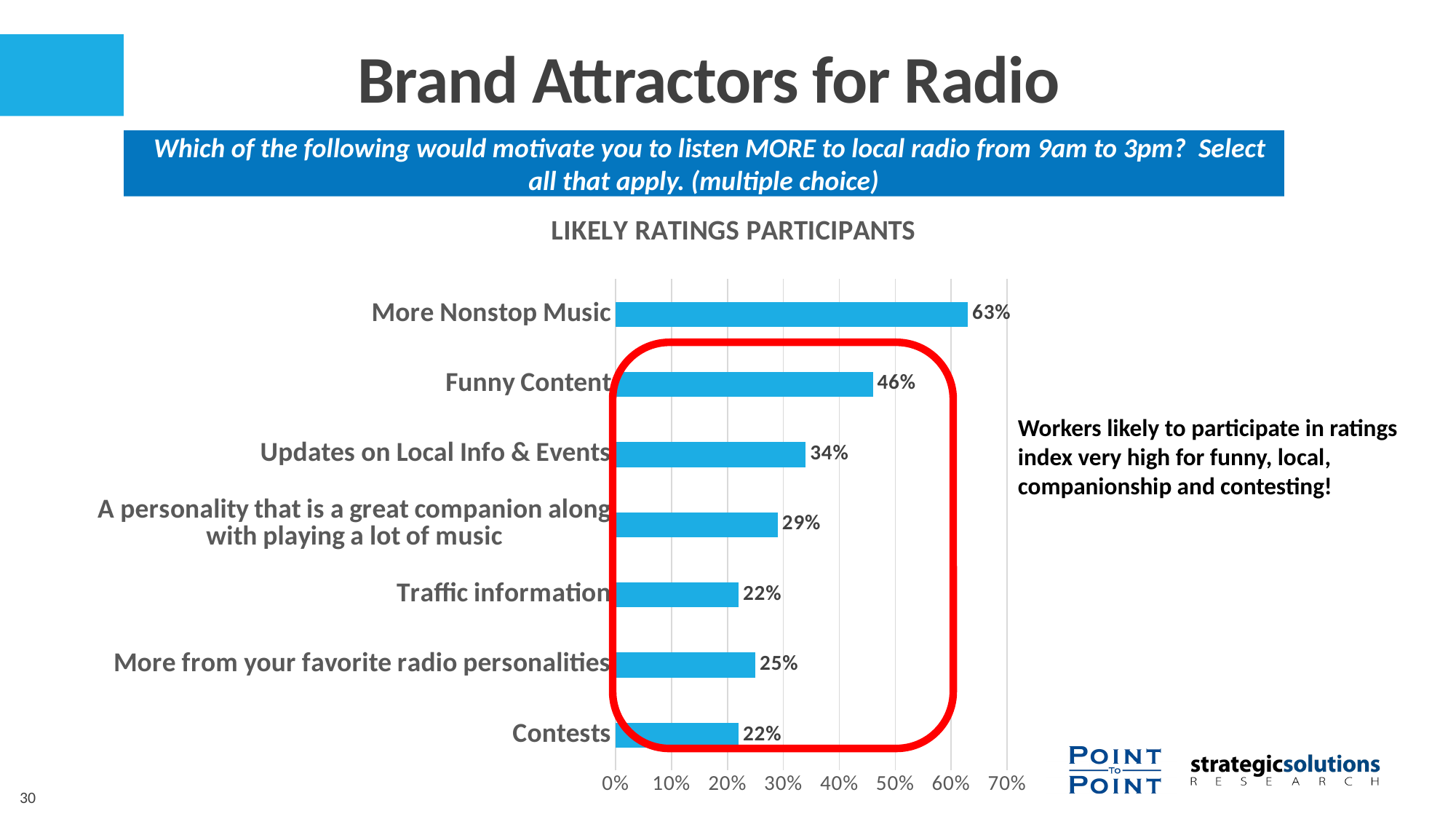
Is the value for A personality that is a great companion along with playing a lot of music greater or less than 20%? greater What is the value for Updates on Local Info & Events? 34% What is the value for Funny Content? 46% What percentage of likely ratings participants selected More Nonstop Music? 63% What is the difference between Updates on Local Info & Events and Traffic information? 12% Which is larger, the value for Traffic information or the value for More from your favorite radio personalities? More from your favorite radio personalities What is the difference between More Nonstop Music and Funny Content? 17% How many categories are shown in the chart? 7 Which category has the highest value? More Nonstop Music What is the value for More from your favorite radio personalities? 25% What is the title of the chart? LIKELY RATINGS PARTICIPANTS What kind of chart is shown on the slide? Bar chart